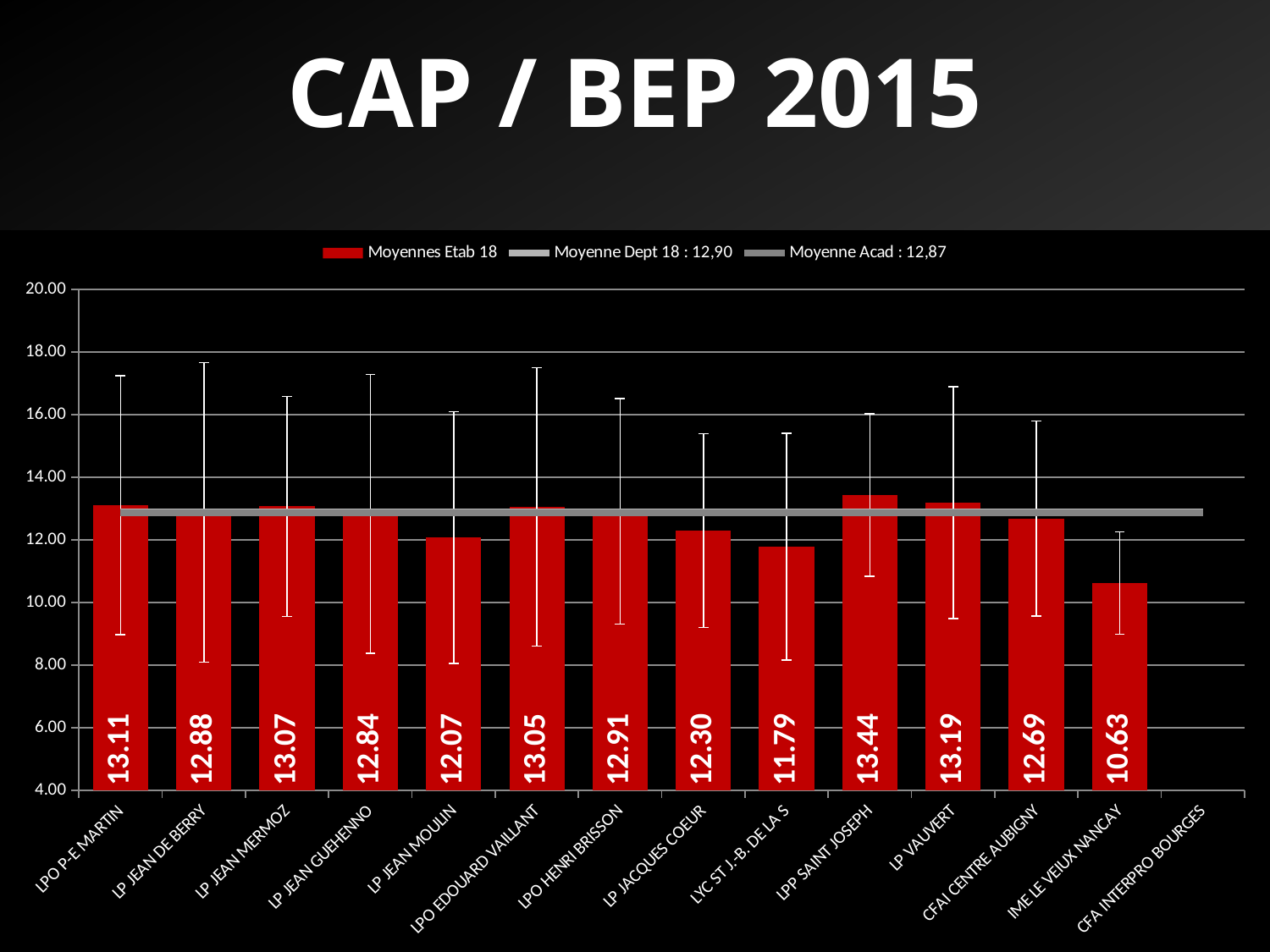
What kind of chart is shown on the slide? bar chart Which has the larger value, LP JEAN MOULIN or LP JACQUES COEUR? LP JACQUES COEUR What is the difference between the values for LPP SAINT JOSEPH and IME LE VEIUX NANCAY? 2.81 What is the value for CFAI CENTRE AUBIGNY? 12.69 How many series does the legend list? 3 What is the value for LP JEAN MOULIN? 12.07 How many red bars are plotted on the chart? 13 Which establishment has the highest value? LPP SAINT JOSEPH What is the value for LPO P-E MARTIN? 13.11 What is the title of the slide? CAP / BEP 2015 Which establishment has the lowest value? IME LE VEIUX NANCAY Is the value for LYC ST J.-B. DE LA S greater or less than 12.00? less